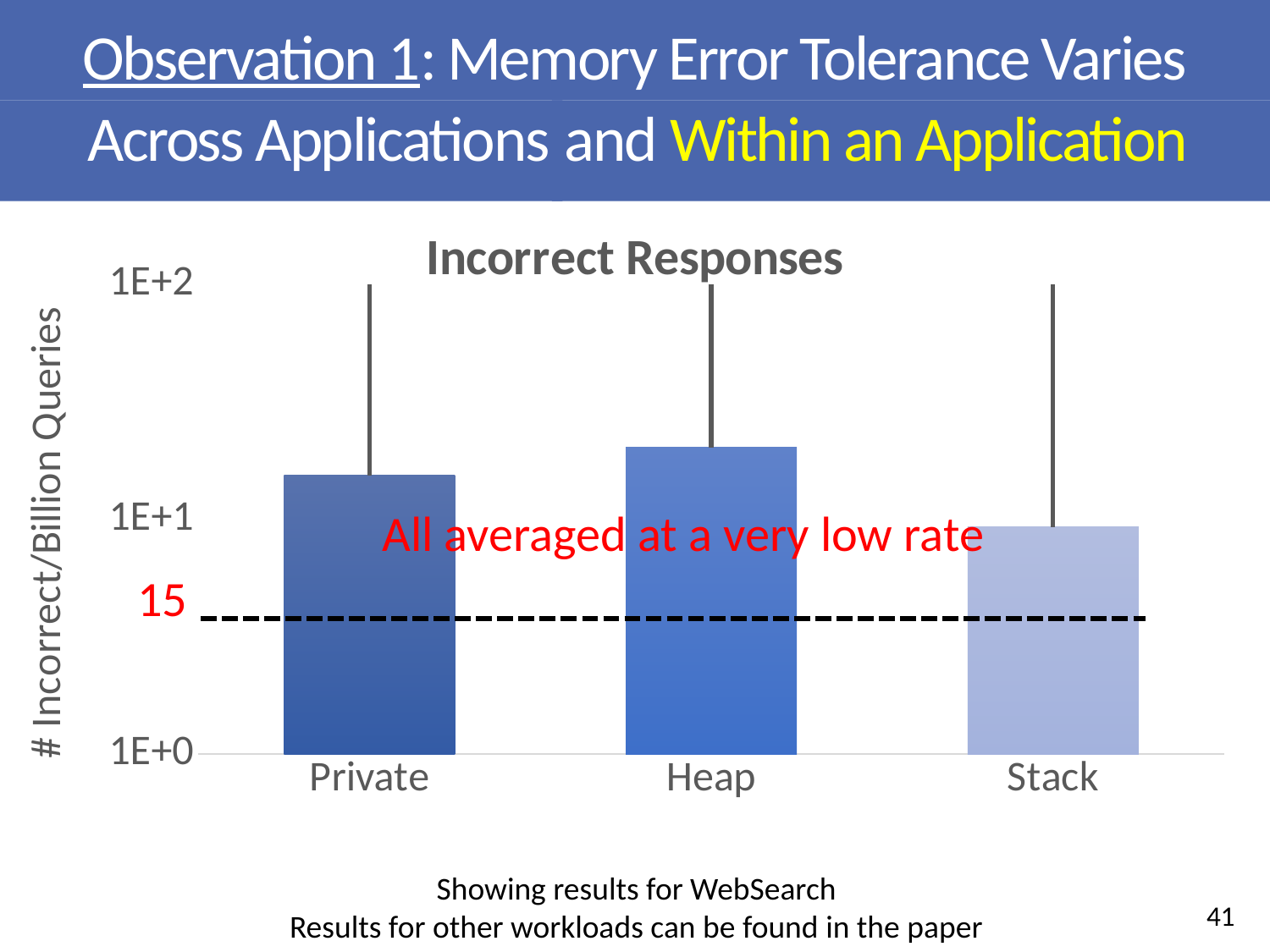
What is the label on the y axis of the chart? # Incorrect/Billion Queries Which bar is taller, Private or Heap? Heap Is the value for Stack greater or less than 1E+2? less Which category has the highest bar in the Incorrect Responses chart? Heap How many categories are plotted on the x axis of the Incorrect Responses chart? 3 Is the value for Heap greater or less than 1E+1? greater What is the title of the chart? Incorrect Responses What kind of chart is shown on the slide? bar chart Is the value for Private greater or less than 1E+1? greater Which bar is taller, Private or Stack? Private Which category has the lowest bar in the Incorrect Responses chart? Stack